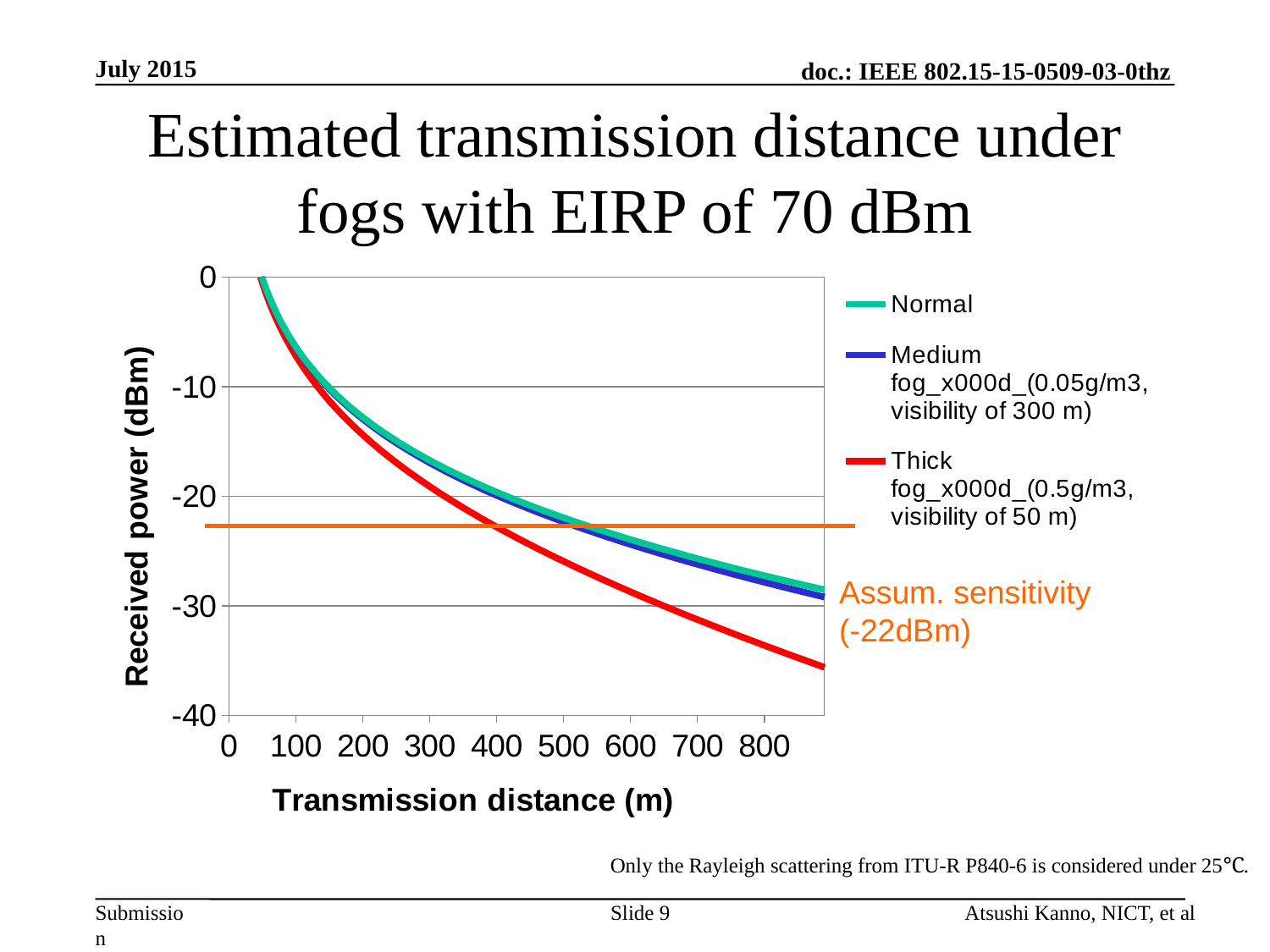
Is the received power for Normal at 800 m greater or less than -30 dBm? greater What kind of chart is shown on the slide? line chart Which series has the highest received power at a transmission distance of 800 m? Normal How many series does the chart legend list? 3 At 600 m, which series has the larger received power, Normal or Thick fog? Normal Which series has the lowest received power at a transmission distance of 800 m? Thick fog (0.5g/m3, visibility of 50 m) Does the received power rise or fall as transmission distance increases? fall Is the received power for Normal at 300 m greater or less than -10 dBm? less What assumed sensitivity value is marked by the orange horizontal line? -22dBm What is the label of the chart's y axis? Received power (dBm) Is the received power for Thick fog at 200 m greater or less than -10 dBm? less